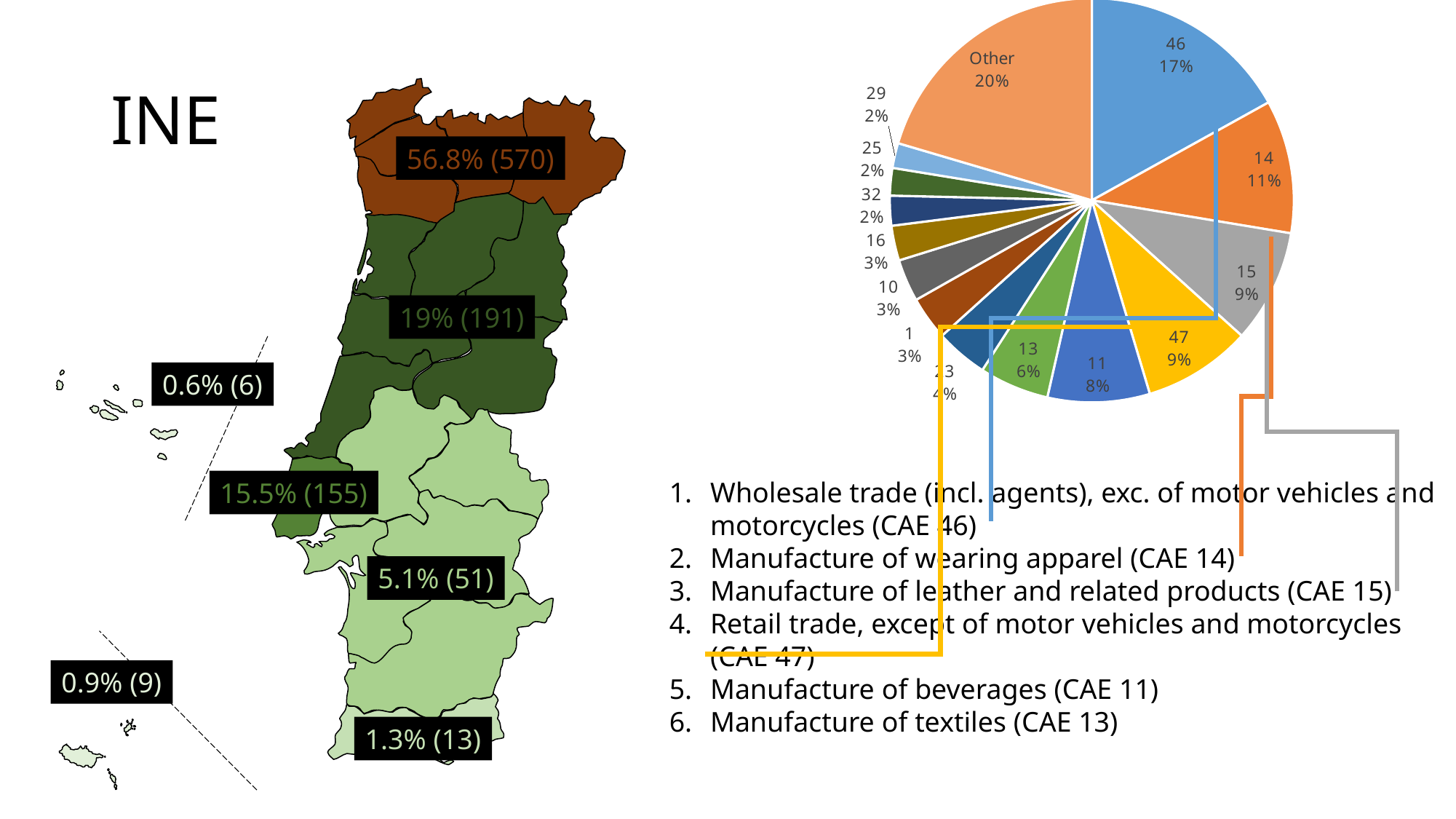
In the pie chart, what percentage is shown for the 'Other' slice? 20% In the pie chart, what percentage is shown for the slice labelled 13? 6% In the pie chart, which has the larger share: slice 46 or slice 14? 46 In the pie chart, what percentage is shown for the slice labelled 11? 8% In the pie chart, what percentage is shown for the slice labelled 14? 11% In the pie chart, what is the difference in percentage points between slice 46 and slice 14? 6% Which slice of the pie chart has the largest share? Other According to the list below the pie chart, which CAE code corresponds to Manufacture of beverages? CAE 11 What kind of chart is shown on the right of the slide? pie chart In the pie chart, what percentage is shown for the slice labelled 47? 9% In the pie chart, what share does the slice labelled 46 have? 17% In the pie chart, what colour is the slice labelled 46? blue